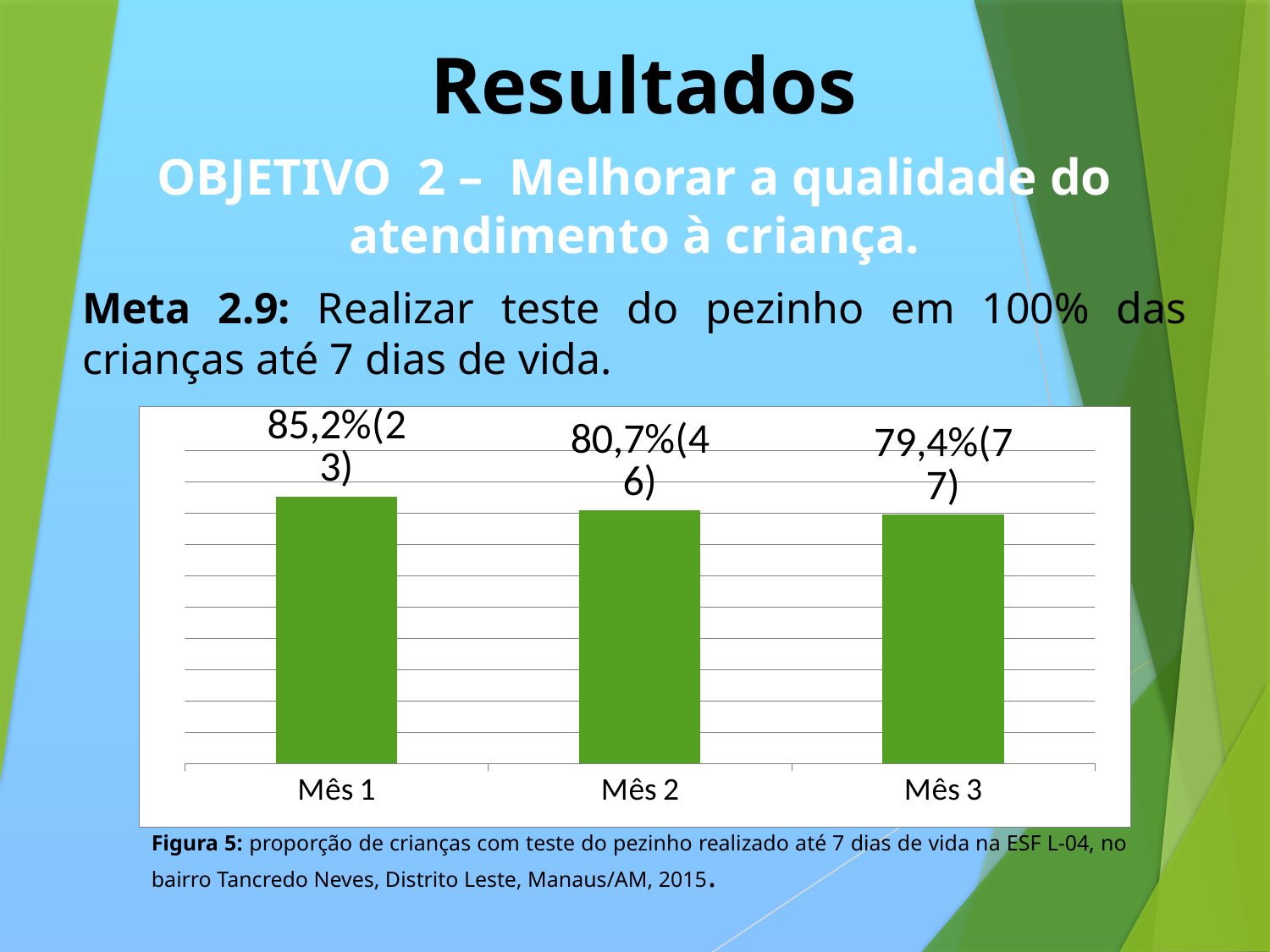
What is the value shown for Mês 3? 79,4%(77) What is the difference in percentage between Mês 1 and Mês 2? 4,5 percentage points What is the value shown for Mês 1? 85,2%(23) Which month has the lowest percentage? Mês 3 Do the percentages rise or fall from Mês 1 to Mês 3? Fall What type of chart is shown on the slide? Bar chart What is the difference in percentage between Mês 2 and Mês 3? 1,3 percentage points Which month has the highest percentage? Mês 1 Which has a higher percentage, Mês 2 or Mês 3? Mês 2 How many months (categories) are shown in the chart? 3 What is the value shown for Mês 2? 80,7%(46) What percentage is shown for Mês 3? 79,4%